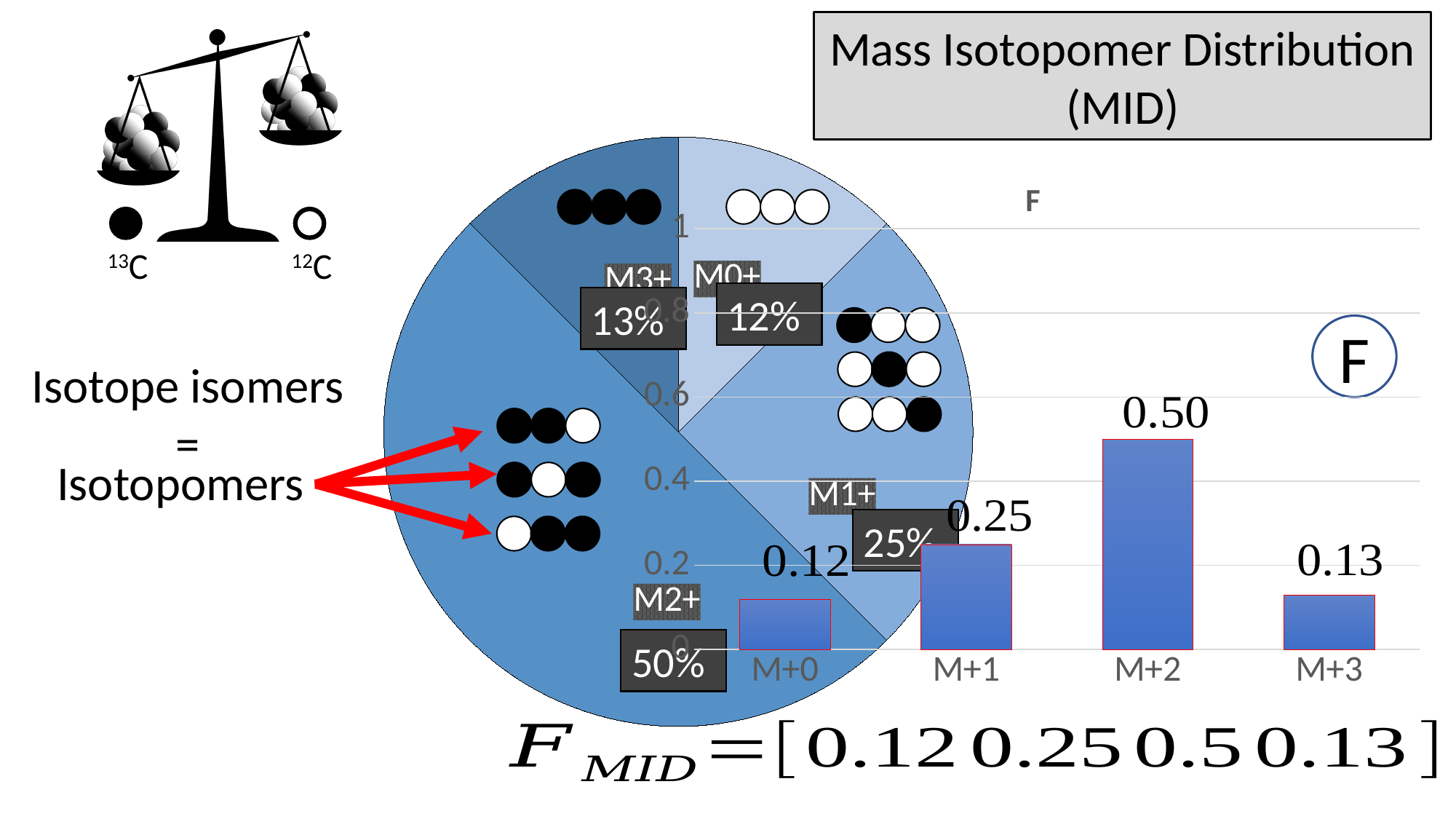
In the bar chart titled F, which is larger, the value for M+1 or the value for M+3? M+1 In the pie chart, which slice is the largest? M2+ What kind of chart is the chart titled F? bar chart What kind of chart is the chart on the left with the M0+, M1+, M2+ and M3+ slices? pie chart In the bar chart titled F, what is the value for M+0? 0.12 In the bar chart titled F, which category has the lowest value? M+0 In the pie chart, what share does the M2+ slice have? 50% In the bar chart titled F, how many categories are shown on the x axis? 4 In the bar chart titled F, what is the difference between the values for M+2 and M+1? 0.25 In the bar chart titled F, which category has the highest value? M+2 In the pie chart, what share does the M0+ slice have? 12% In the bar chart titled F, what is the value for M+2? 0.50